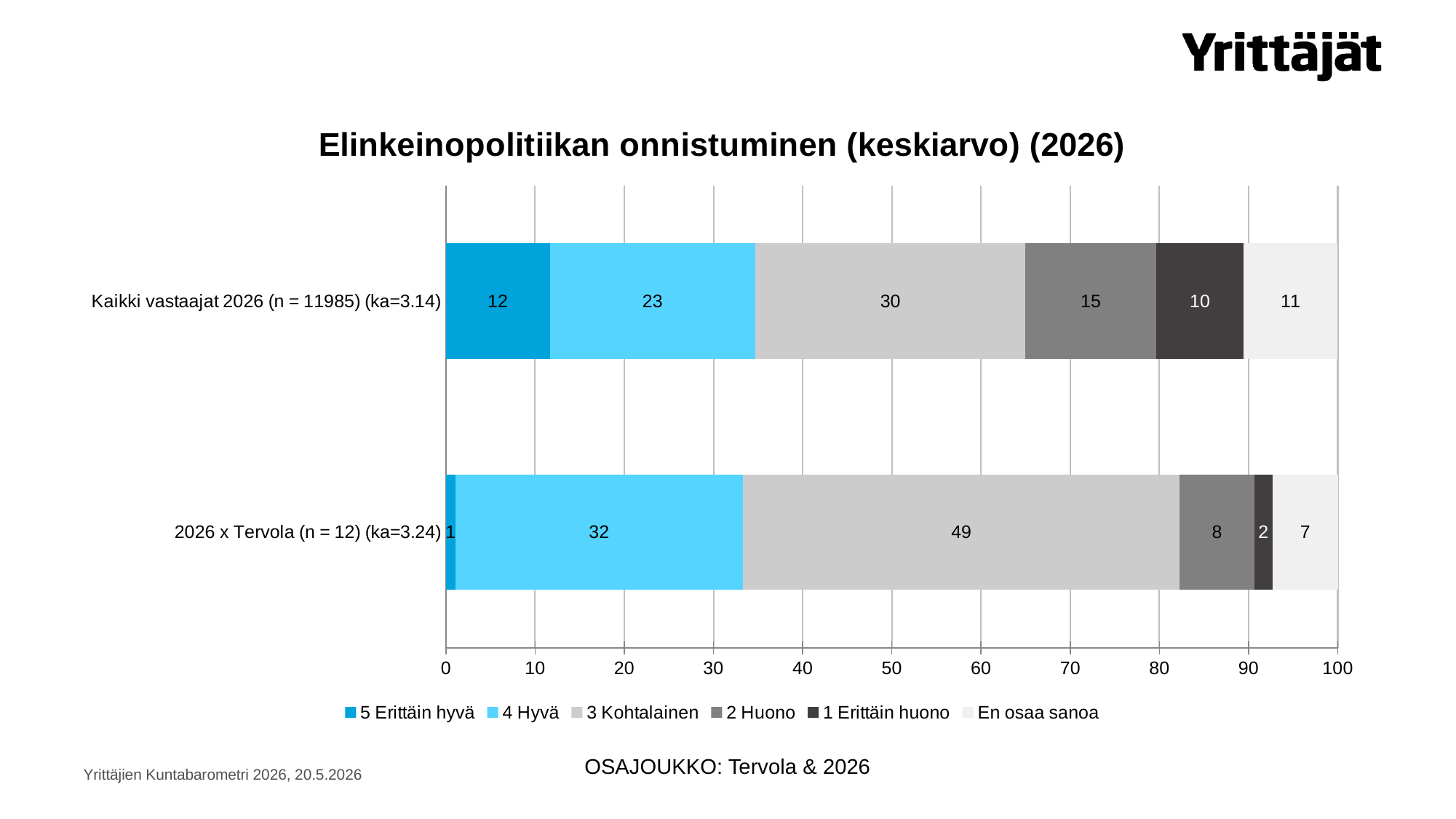
Which series has the smallest value in the "2026 x Tervola (n = 12) (ka=3.24)" bar? 5 Erittäin hyvä What is the value of "3 Kohtalainen" for "Kaikki vastaajat 2026 (n = 11985) (ka=3.14)"? 30 What is the value of "4 Hyvä" for "2026 x Tervola (n = 12) (ka=3.24)"? 32 What is the difference between the "3 Kohtalainen" values for "2026 x Tervola (n = 12) (ka=3.24)" and "Kaikki vastaajat 2026 (n = 11985) (ka=3.14)"? 19 How many categories (bars) are shown in the chart? 2 What is the value of "1 Erittäin huono" for "Kaikki vastaajat 2026 (n = 11985) (ka=3.14)"? 10 What is the value of "En osaa sanoa" for "2026 x Tervola (n = 12) (ka=3.24)"? 7 What is the total of the "2026 x Tervola (n = 12) (ka=3.24)" stacked bar? 99 How many series does the legend list? 6 Which series has the largest value in the "2026 x Tervola (n = 12) (ka=3.24)" bar? 3 Kohtalainen What type of chart is shown on the slide? Stacked bar chart Which bar has the larger value for "2 Huono": "Kaikki vastaajat 2026 (n = 11985) (ka=3.14)" or "2026 x Tervola (n = 12) (ka=3.24)"? Kaikki vastaajat 2026 (n = 11985) (ka=3.14)